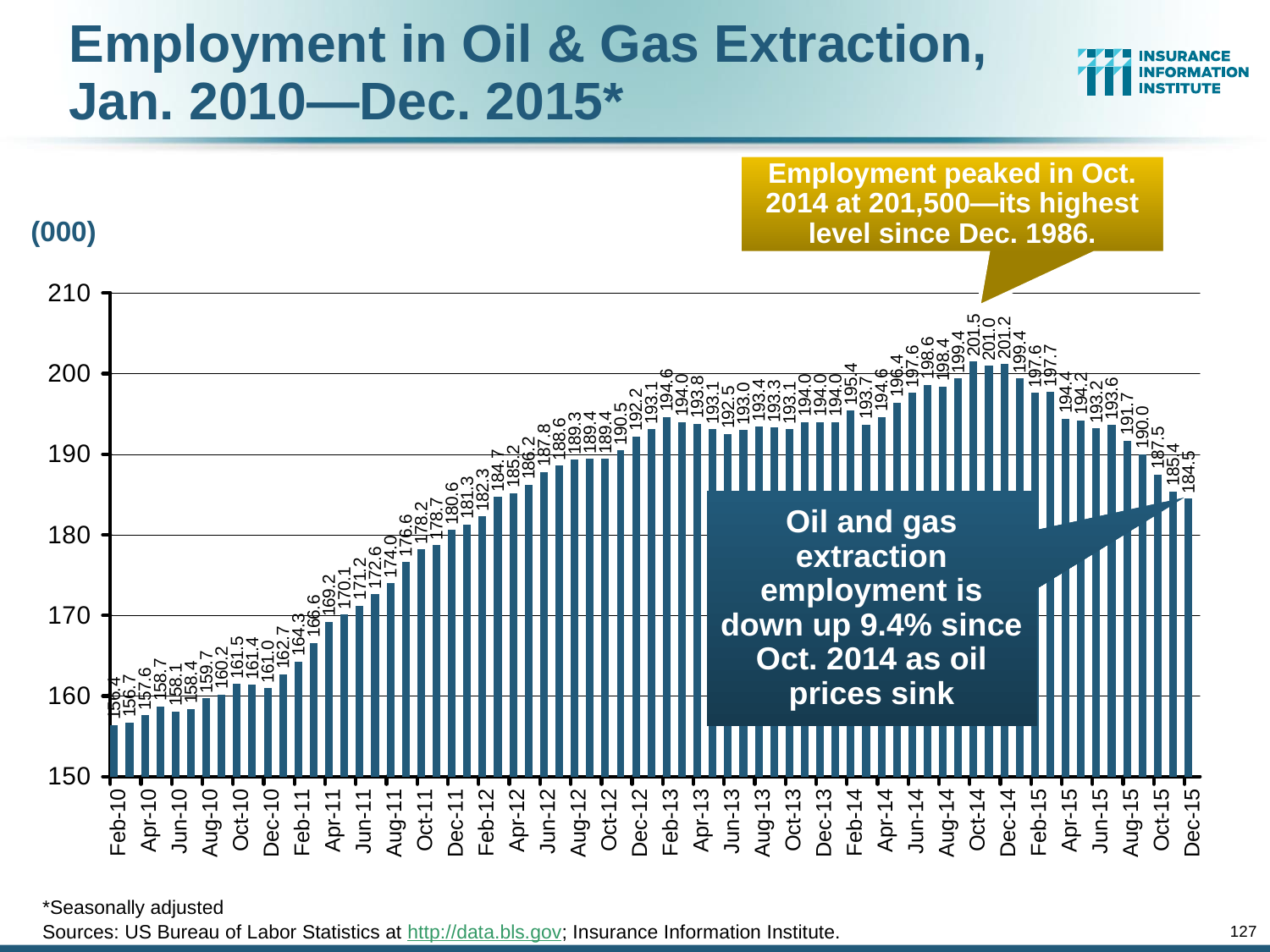
In what units are the employment values shown, according to the label above the y axis? (000) Which is larger, the value for Oct-14 or the value for Dec-15? Oct-14 Do the values generally rise or fall from Oct-14 to Dec-15? fall What is the employment value for Feb-10? 156.4 Is the value for Oct-14 greater or less than 200? greater Do the values generally rise or fall from Feb-10 to Oct-14? rise Is the value for Dec-15 greater or less than 190? less What kind of chart is shown on the slide? Bar chart What is the employment value for Dec-15? 184.5 Which month has the highest employment value? Oct-14 What is the difference between the Oct-14 value and the Dec-15 value? 17.0 What is the employment value for Oct-14? 201.5